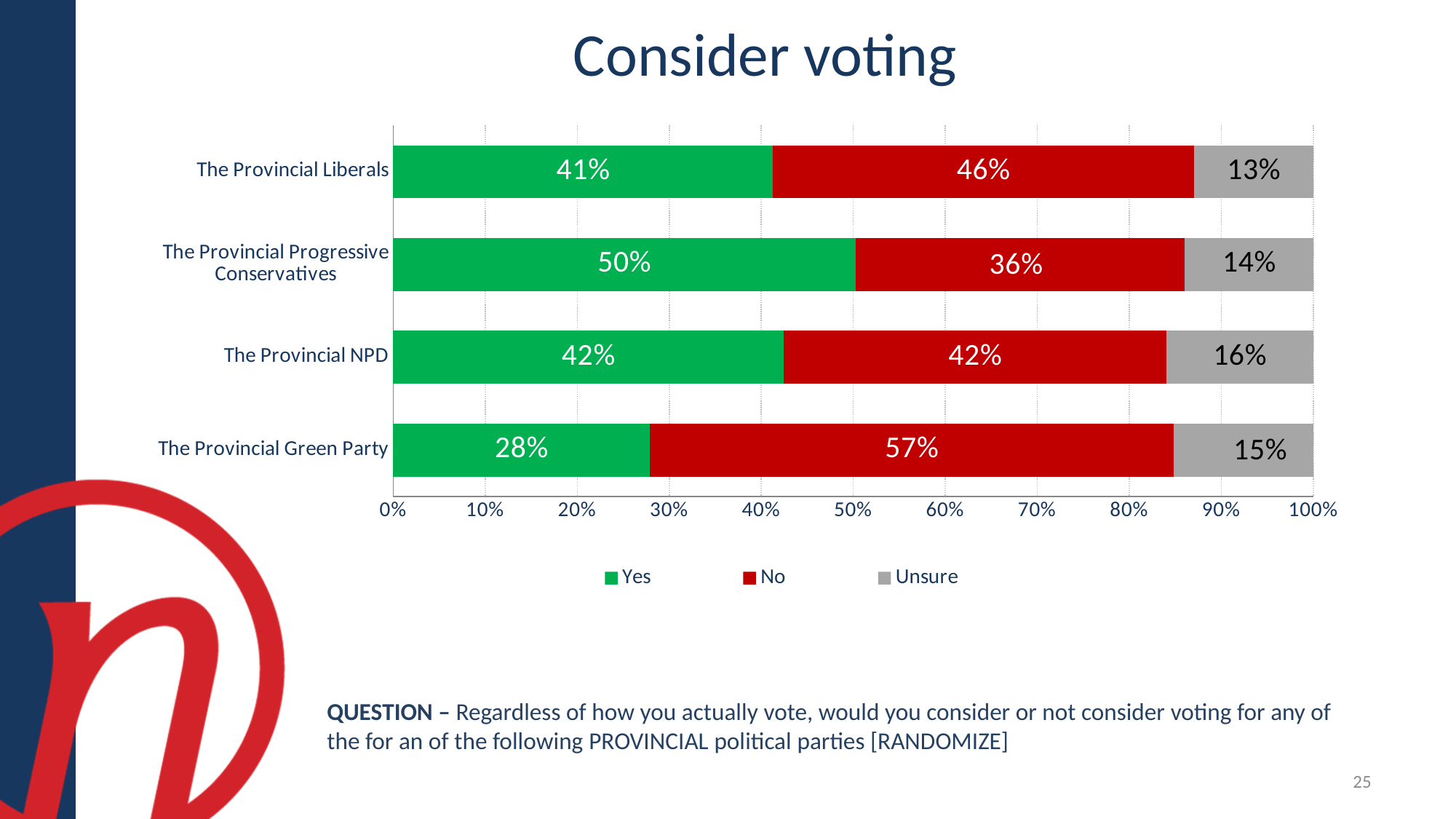
Which party has the lowest Unsure percentage? The Provincial Liberals What is the difference between the No and Yes percentages for The Provincial Green Party? 29% How many parties are shown in the chart? 4 What kind of chart is shown on the slide? Stacked bar chart What is the Unsure value for The Provincial NPD? 16% What percentage of respondents said Yes for The Provincial Progressive Conservatives? 50% What colour represents the No responses in the chart? Red Which party has the highest Yes percentage? The Provincial Progressive Conservatives What percentage of respondents said No for The Provincial Green Party? 57% Is the Yes percentage higher for The Provincial Liberals or The Provincial Progressive Conservatives? The Provincial Progressive Conservatives How many series does the legend list? 3 Which party has the lowest Yes percentage? The Provincial Green Party